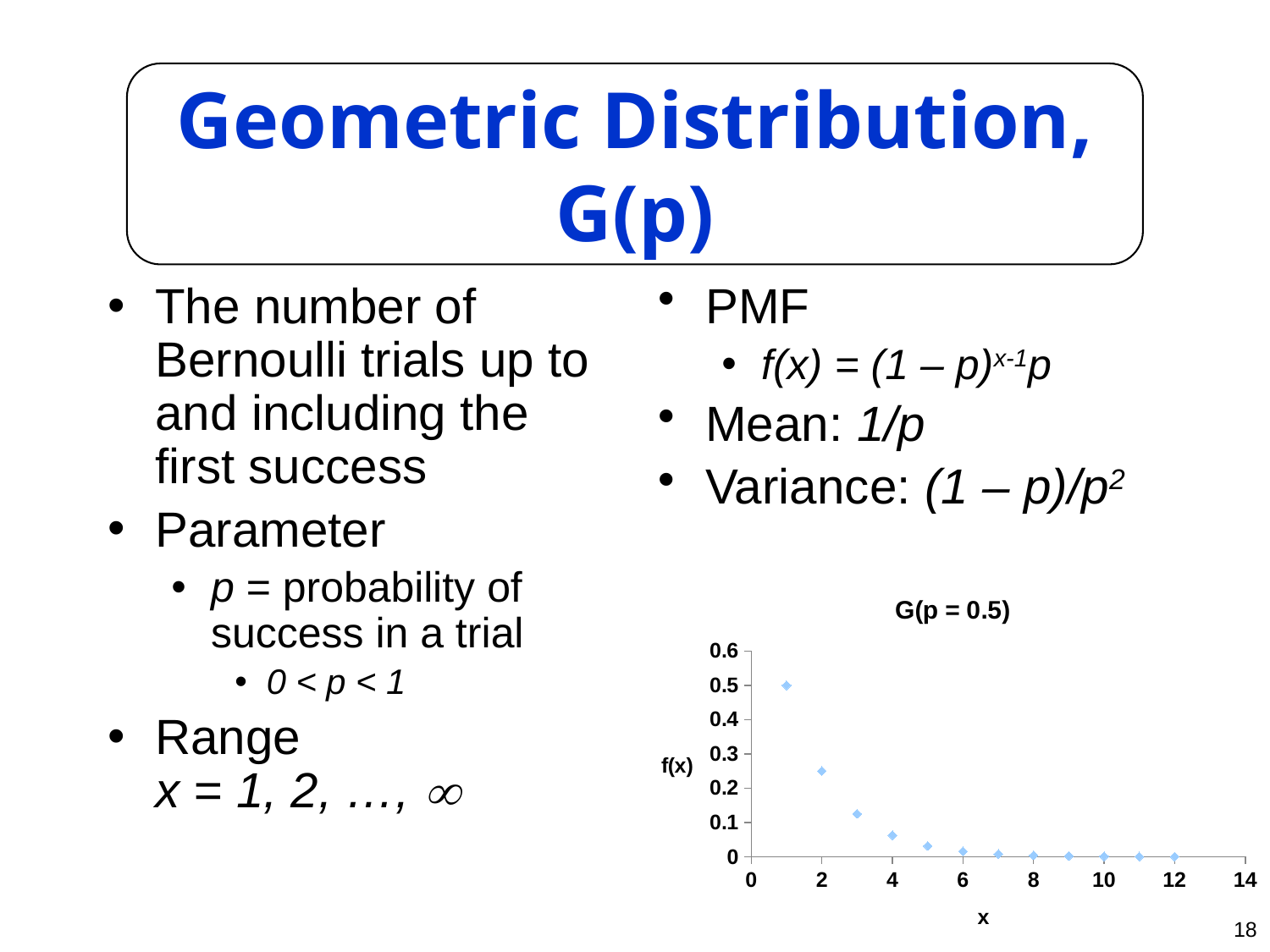
What is the label of the vertical axis of the chart? f(x) Is the value of f(x) at x = 3 greater or less than 0.1? greater At which value of x is f(x) highest in the chart? 1 Is the value of f(x) at x = 2 greater or less than 0.2? greater Is the value of f(x) at x = 2 greater or less than 0.3? less What kind of chart is shown on the slide? scatter chart What is the value of f(x) at x = 1 in the chart? 0.5 Which is larger, f(x) at x = 1 or f(x) at x = 2? x = 1 Do the plotted values rise or fall as x increases? fall How many data points are plotted in the chart? 12 What is the title of the chart on the slide? G(p = 0.5)